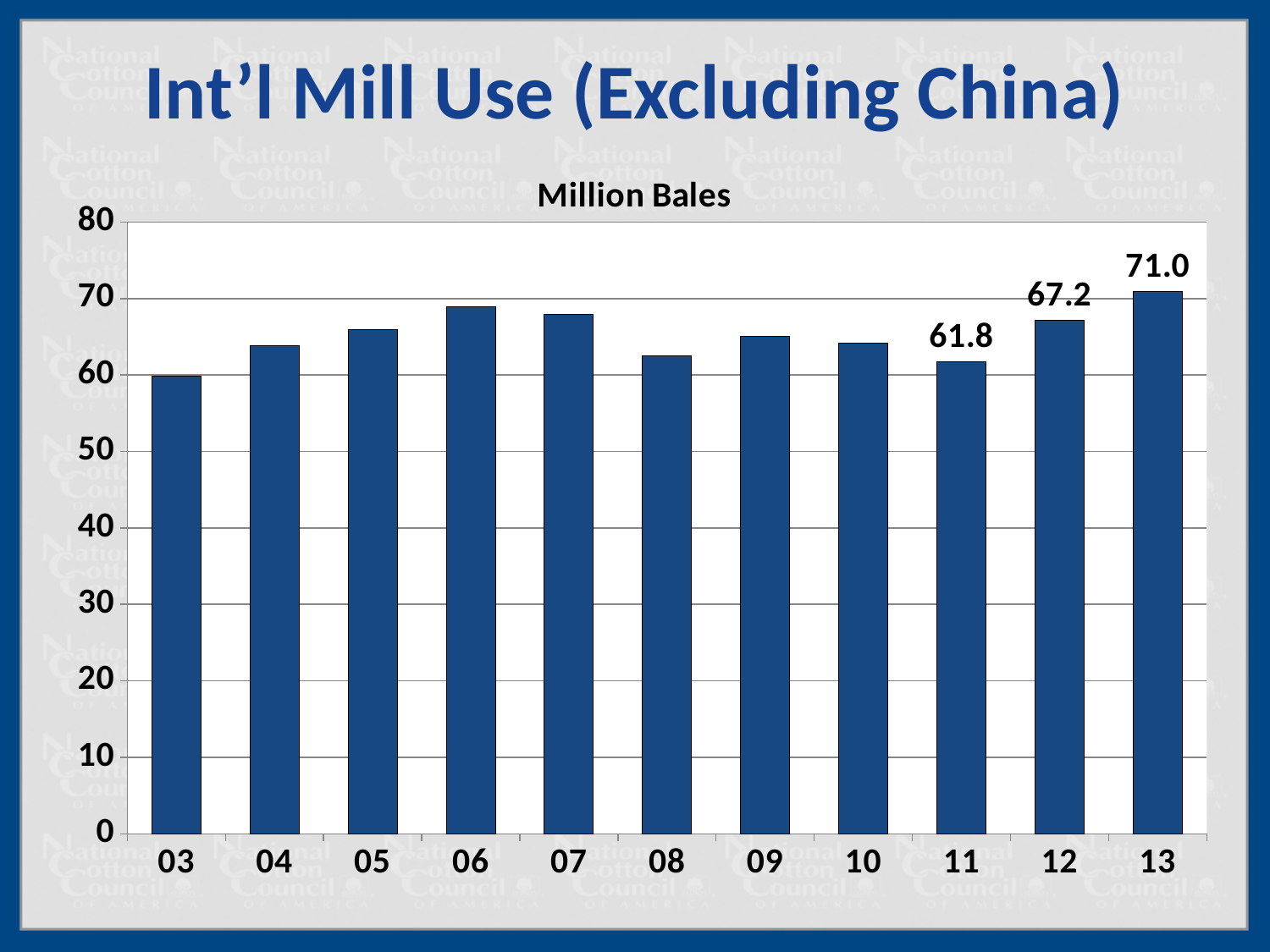
Which year has the highest value? 13 What is the value for 11? 61.8 What is the difference between the values for 13 and 11? 9.2 Is the value for 06 greater or less than 60? greater Which is larger, the value for 12 or the value for 11? 12 Do the values rise or fall from 11 to 13? rise What is the value for 13? 71.0 What is the value for 12? 67.2 Is the value for 03 greater or less than 70? less What is the difference between the values for 13 and 12? 3.8 What kind of chart is shown? bar chart How many years are shown on the x axis? 11